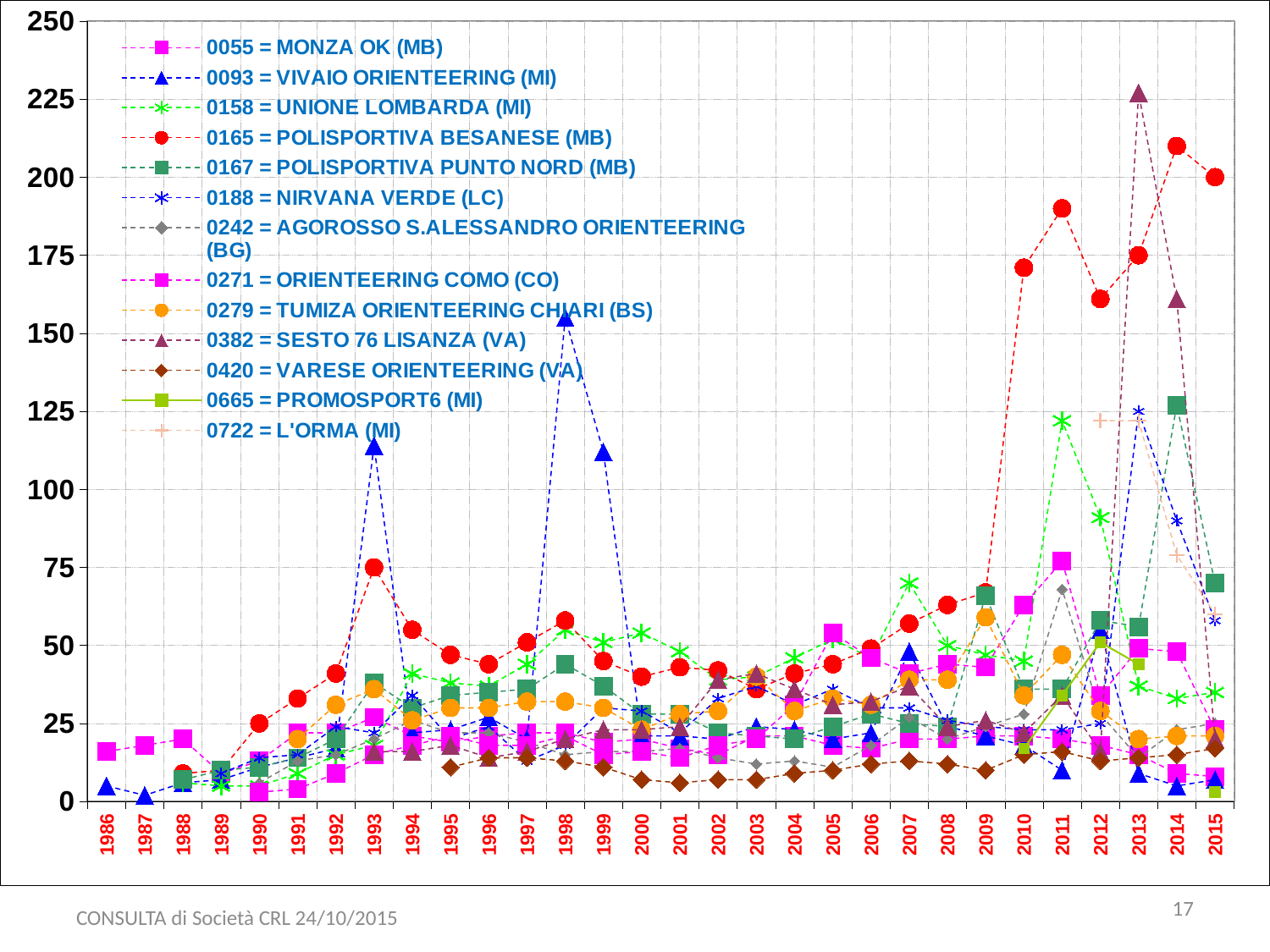
Which series has the highest value in 2013? 0382 = SESTO 76 LISANZA (VA) Is the value for 0093 = VIVAIO ORIENTEERING (MI) in 1998 greater or less than 125? greater How many series does the legend list? 13 Is the value for 0165 = POLISPORTIVA BESANESE (MB) in 2014 greater or less than 200? greater What kind of chart is shown on the slide? line chart For 0165 = POLISPORTIVA BESANESE (MB), is the value larger in 2011 or in 2012? 2011 How many years are shown along the x axis? 30 Which club name does the legend give for code 0188? NIRVANA VERDE (LC) Is the value for 0420 = VARESE ORIENTEERING (VA) in 2001 greater or less than 25? less Does the value for 0165 = POLISPORTIVA BESANESE (MB) rise or fall from 2009 to 2011? rise Which series has the highest value in 2015? 0165 = POLISPORTIVA BESANESE (MB)